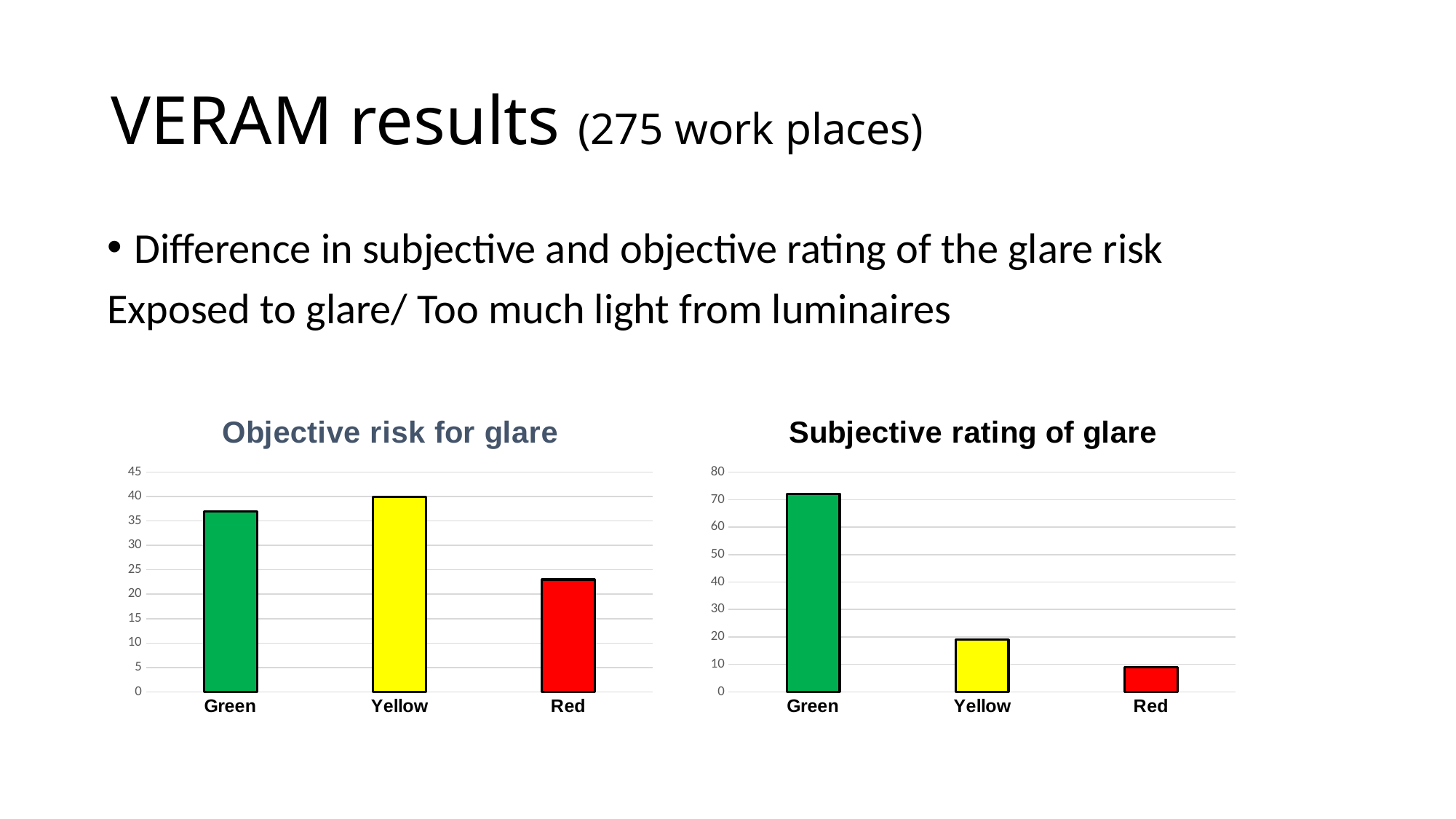
In the 'Subjective rating of glare' chart, which category has the highest value? Green In the 'Objective risk for glare' chart, which category has the highest value? Yellow In the 'Subjective rating of glare' chart, which is larger, the value for Yellow or the value for Red? Yellow In the 'Subjective rating of glare' chart, is the value for Green greater or less than 70? greater How many categories are shown in the 'Objective risk for glare' chart? 3 What is the title of the chart on the left side of the slide? Objective risk for glare In the 'Objective risk for glare' chart, which category has the lowest value? Red In the 'Subjective rating of glare' chart, which category has the lowest value? Red In the 'Objective risk for glare' chart, is the value for Red greater or less than 25? less What kind of chart is the 'Subjective rating of glare' chart? Bar chart In the 'Objective risk for glare' chart, is the value for Green greater or less than 35? greater